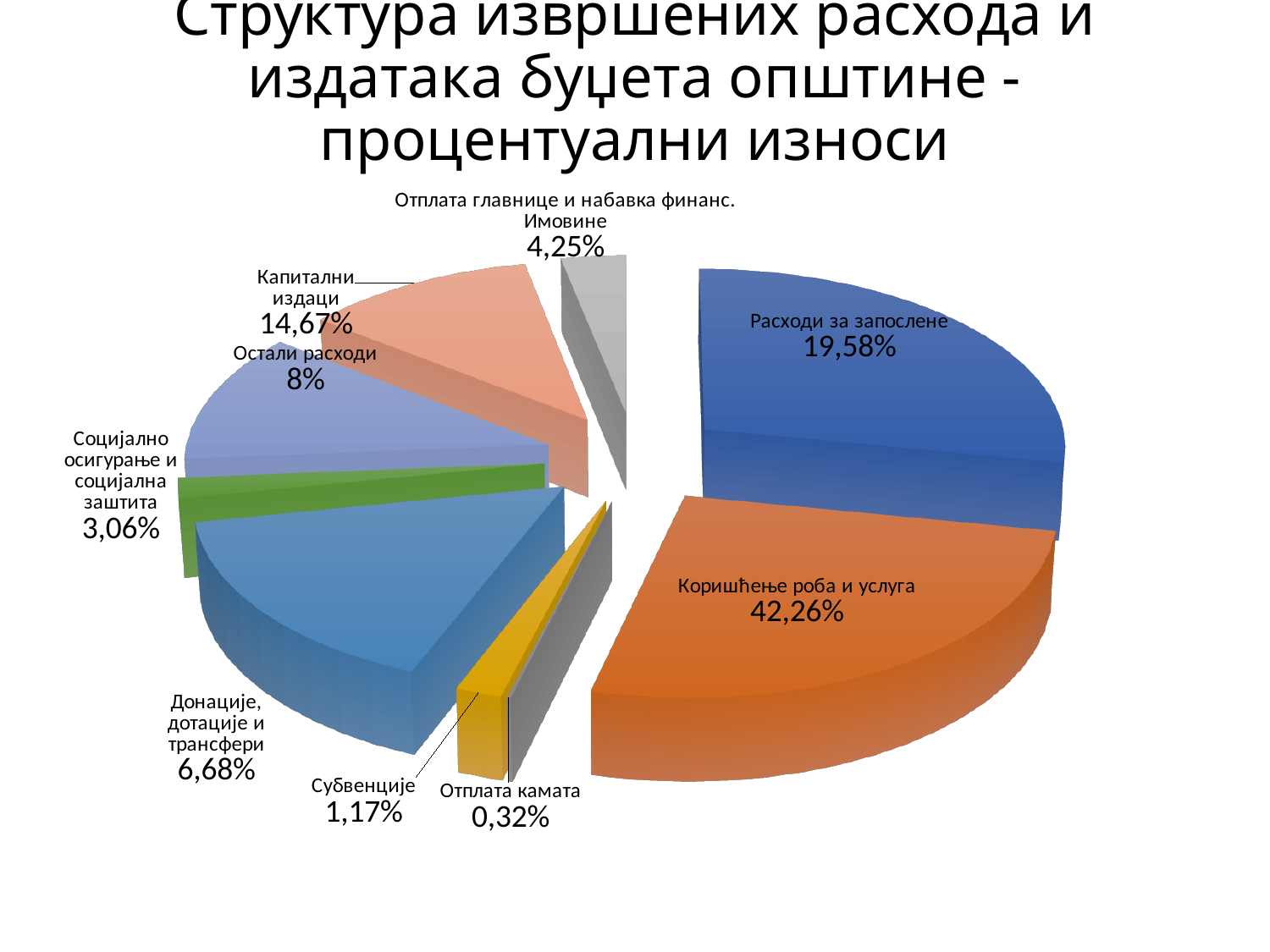
What percentage is shown for Капитални издаци? 14,67% What share of the pie does Субвенције take? 1,17% What is the value shown for Расходи за запослене? 19,58% Which category has the smallest share of the pie? Отплата камата What is the value for Отплата главнице и набавка финанс. имовине? 4,25% What type of chart is shown on the slide? Pie chart Which is larger: Донације, дотације и трансфери or Социјално осигурање и социјална заштита? Донације, дотације и трансфери How many categories (slices) does the pie chart have? 9 What percentage does the slice for Коришћење роба и услуга represent? 42,26% Which category has the largest share of the pie? Коришћење роба и услуга What is the difference between the shares of Коришћење роба и услуга and Расходи за запослене? 22,68% What is the difference between Капитални издаци and Остали расходи? 6,67%